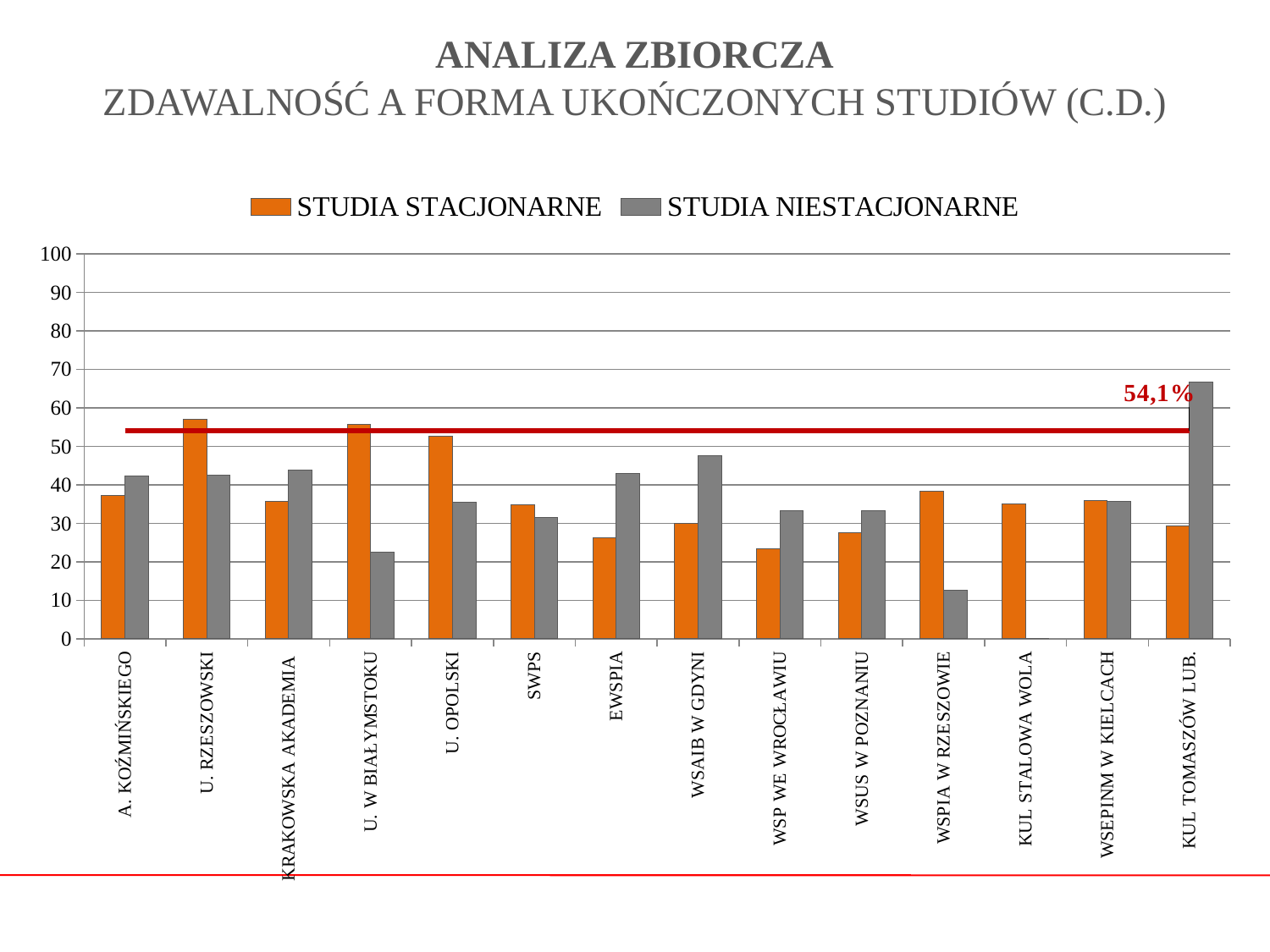
Which institution has the highest value for STUDIA NIESTACJONARNE? KUL TOMASZÓW LUB. What value is labelled on the horizontal red reference line? 54,1% For EWSPIA, which is larger: STUDIA STACJONARNE or STUDIA NIESTACJONARNE? STUDIA NIESTACJONARNE For U. W BIAŁYMSTOKU, which is larger: STUDIA STACJONARNE or STUDIA NIESTACJONARNE? STUDIA STACJONARNE Is the STUDIA NIESTACJONARNE value for WSPIA W RZESZOWIE greater or less than 20? less Which institution has the lowest value for STUDIA STACJONARNE? WSP WE WROCŁAWIU Is the STUDIA NIESTACJONARNE value for U. W BIAŁYMSTOKU greater or less than 30? less How many series does the legend list? 2 How many institutions (categories) are shown on the x axis? 14 Is the STUDIA STACJONARNE value for U. OPOLSKI greater or less than 50? greater What kind of chart is shown on the slide? bar chart